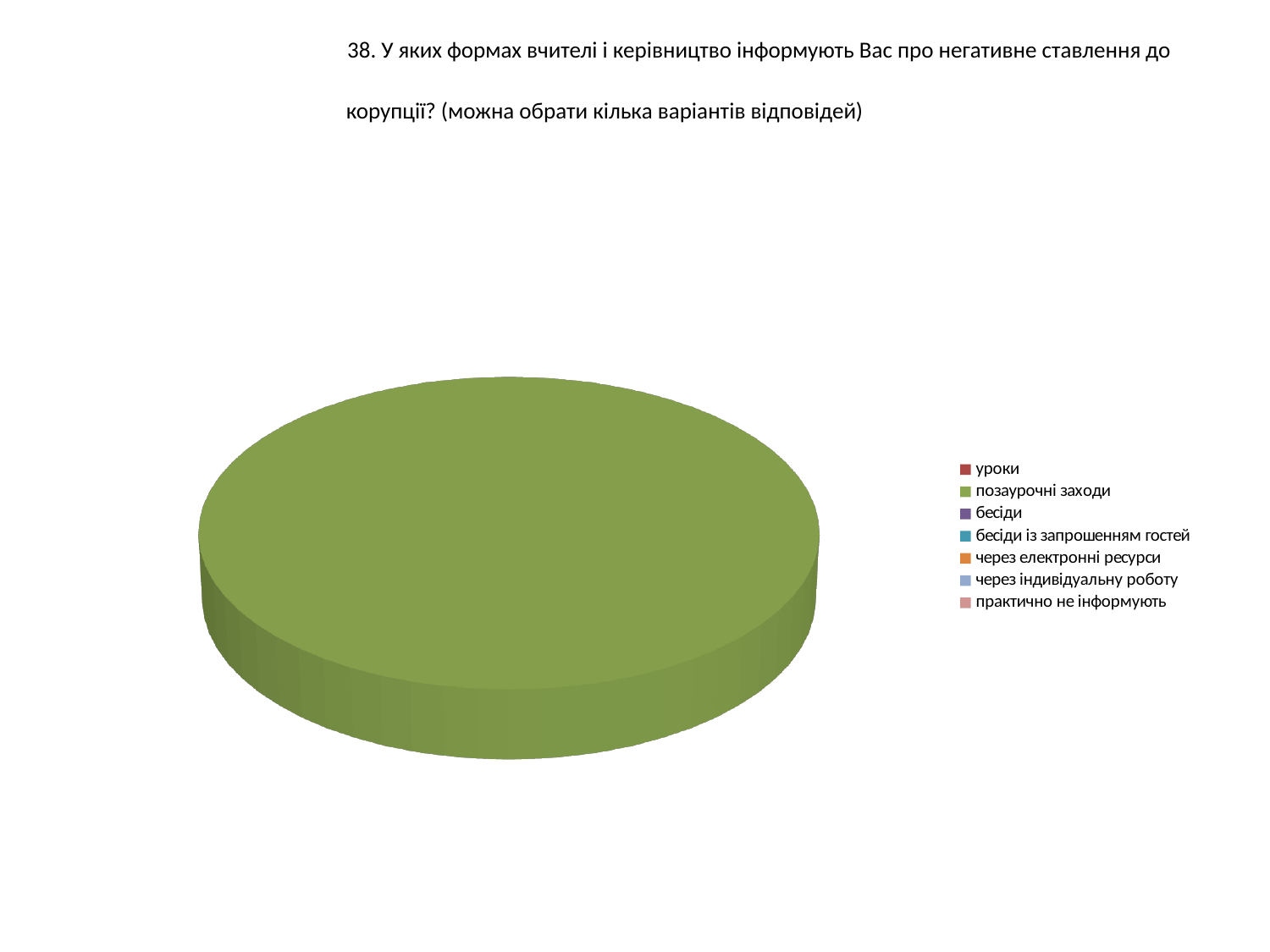
Which legend category is the only one visibly occupying the pie? позаурочні заходи Which category accounts for the largest share of the pie chart? позаурочні заходи Which legend entry is listed first in the pie chart's legend? уроки How many categories does the legend of the pie chart list? 7 What colour is the slice that fills the pie chart? green Is the share of the pie for 'позаурочні заходи' larger than the share for 'уроки'? Yes What kind of chart is shown on the slide? pie chart